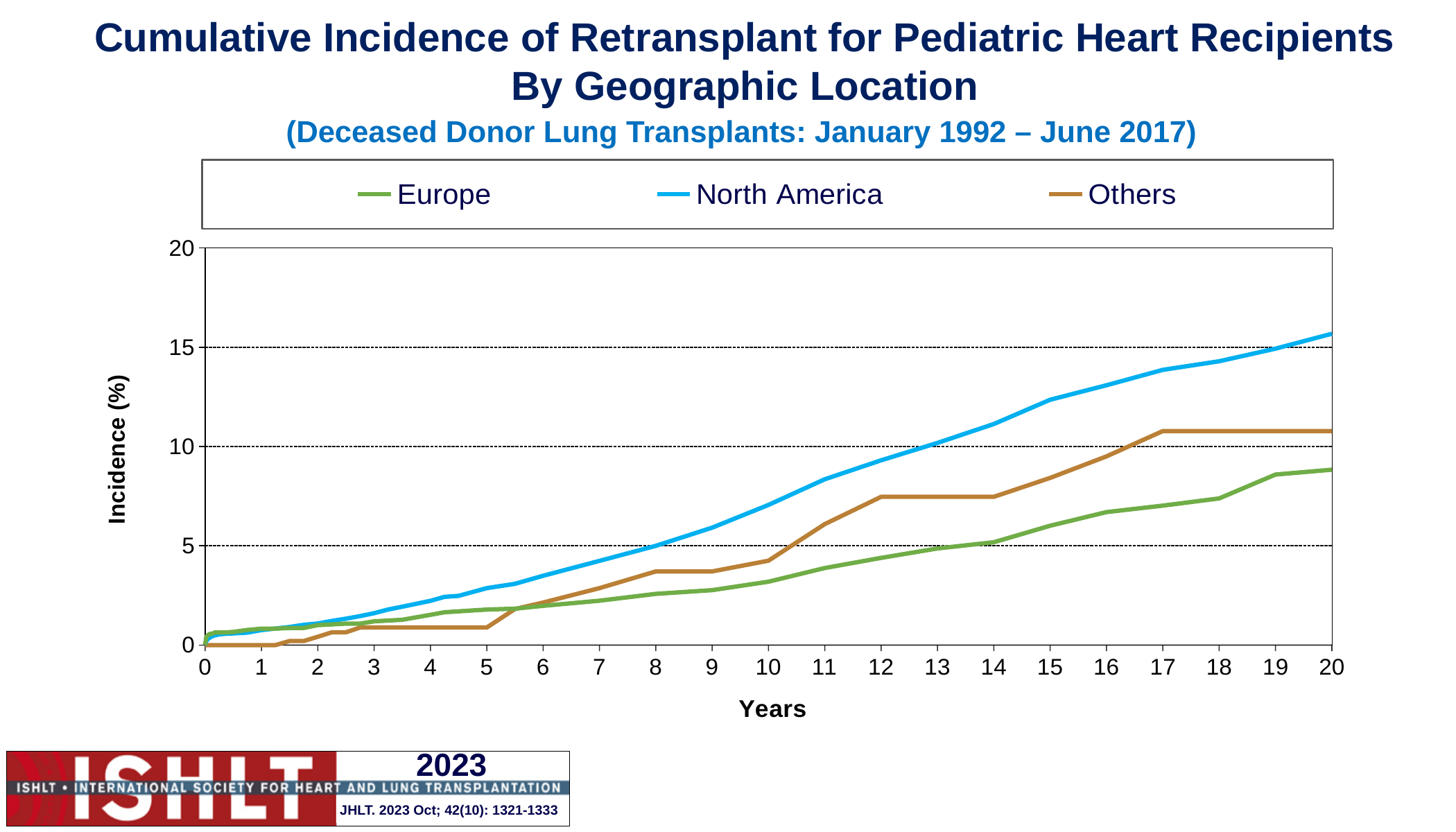
Do the values for North America rise or fall as years increase? rise What is the label of the y axis? Incidence (%) At 5 years, which is larger: the value for Europe or the value for Others? Europe Which series has the lowest incidence at 20 years? Europe At 12 years, which is larger: the value for Others or the value for Europe? Others Is the value for North America at 10 years greater or less than 10? less Is the value for Europe at 20 years greater or less than 10? less Is the value for North America at 20 years greater or less than 15? greater How many series does the legend list? 3 What kind of chart is shown on the slide? line chart Which series has the highest incidence at 20 years? North America